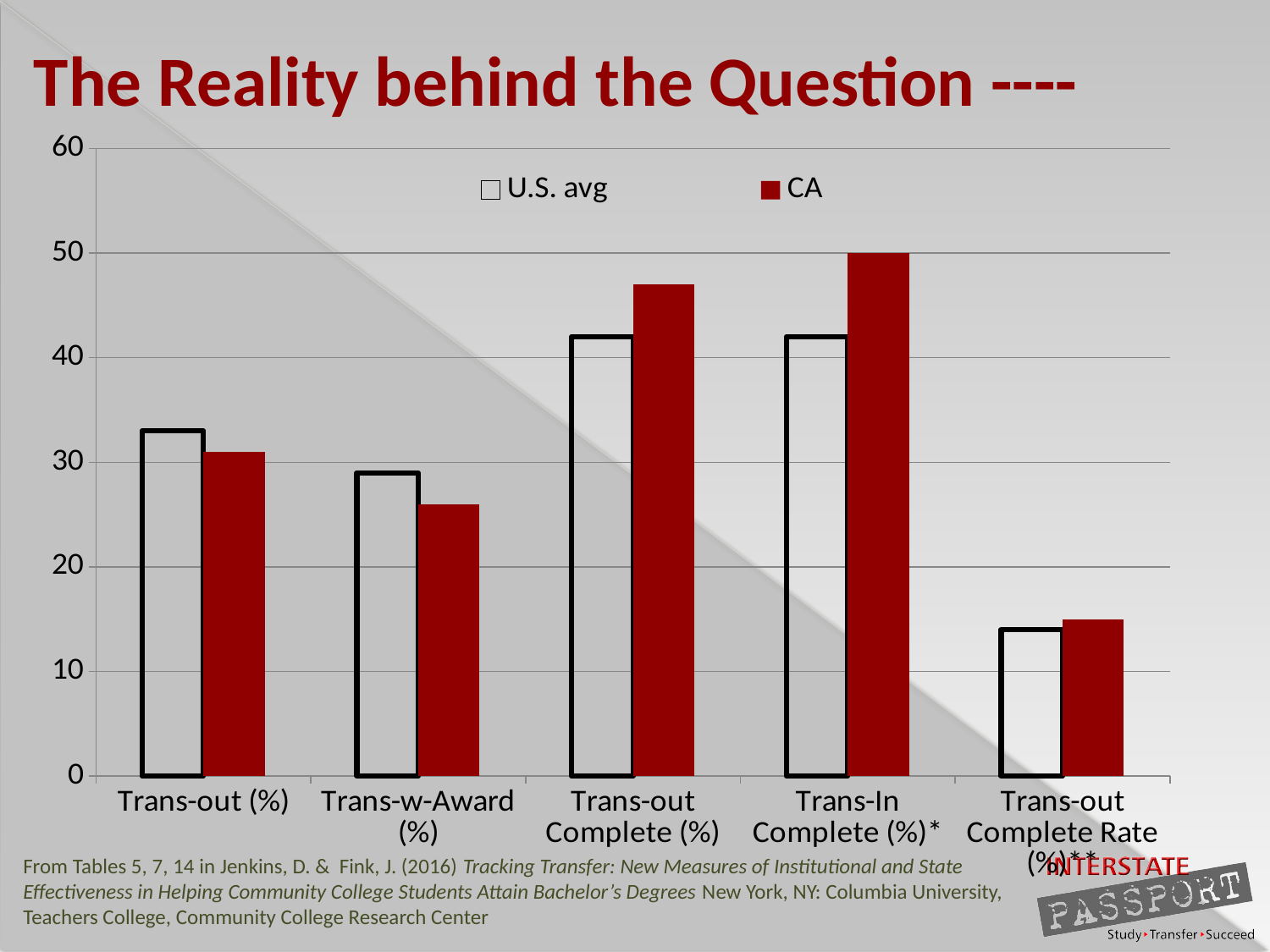
What colour are the CA bars? dark red How many series does the legend list? 2 Which category has the lowest U.S. avg value? Trans-out Complete Rate (%)** Is the U.S. avg value for Trans-out (%) greater or less than 30? greater Which category has the lowest CA value? Trans-out Complete Rate (%)** What kind of chart is shown on the slide? bar chart Is the CA value for Trans-w-Award (%) greater or less than 30? less How many categories are shown on the x axis? 5 Which category has the highest CA value? Trans-In Complete (%)* For Trans-w-Award (%), which is larger, U.S. avg or CA? U.S. avg For Trans-out Complete (%), which is larger, U.S. avg or CA? CA Is the CA value for Trans-out Complete (%) greater or less than 40? greater